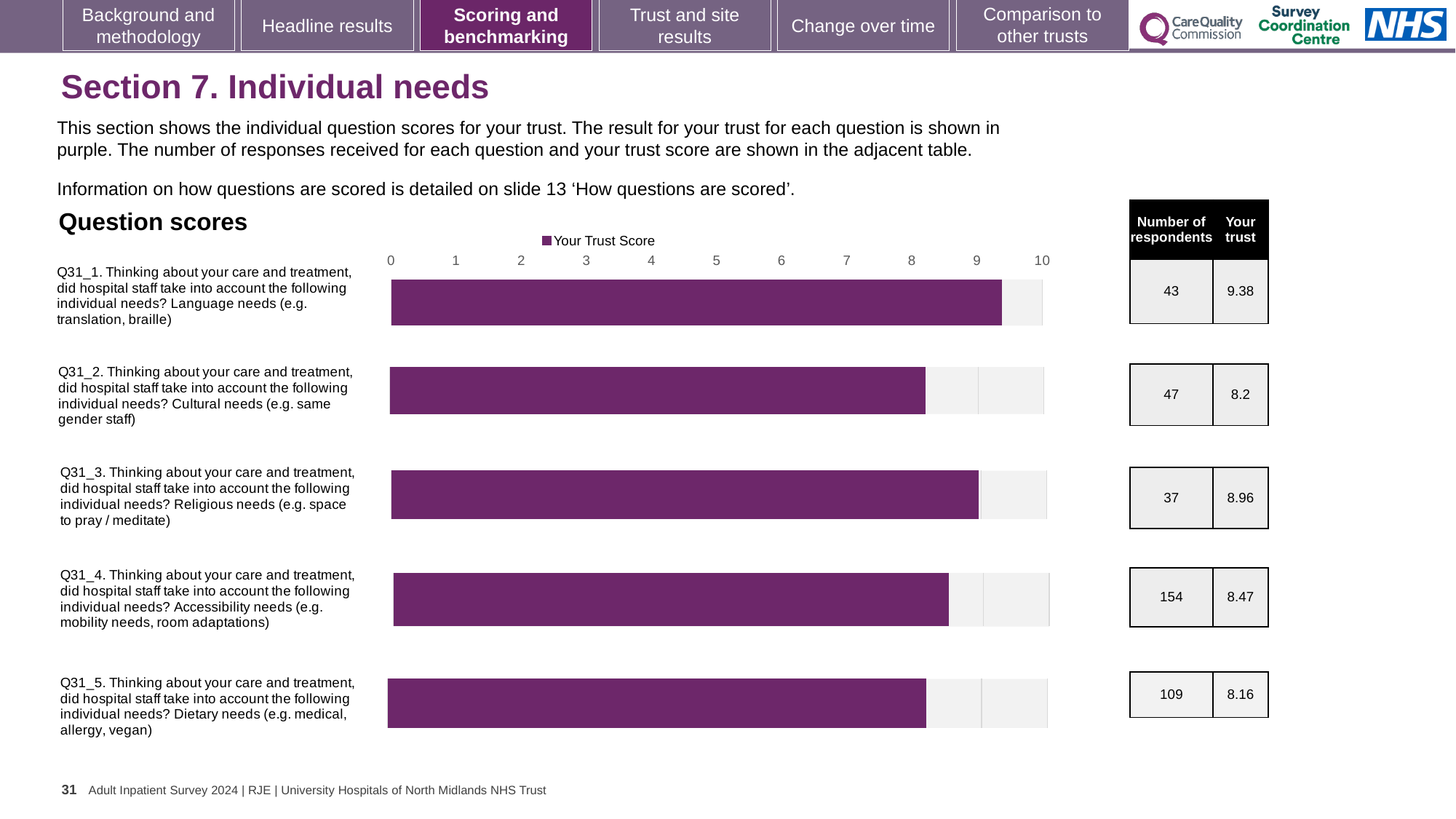
Which question has the lowest trust score? Q31_5 (Dietary needs) What is the trust score for Q31_1 (Language needs)? 9.38 Which question has the highest trust score? Q31_1 (Language needs) How many respondents answered Q31_5 (Dietary needs)? 109 What type of chart is used to show the question scores? Bar chart Which has a higher trust score, Q31_3 (Religious needs) or Q31_4 (Accessibility needs)? Q31_3 (Religious needs) What is the name of the series shown in the chart legend? Your Trust Score Is the trust score for Q31_2 (Cultural needs) greater or less than 9? less How many series does the chart legend list? 1 What is the trust score for Q31_4 (Accessibility needs)? 8.47 What is the difference between the trust scores for Q31_1 and Q31_2? 1.18 How many questions are plotted in the chart? 5